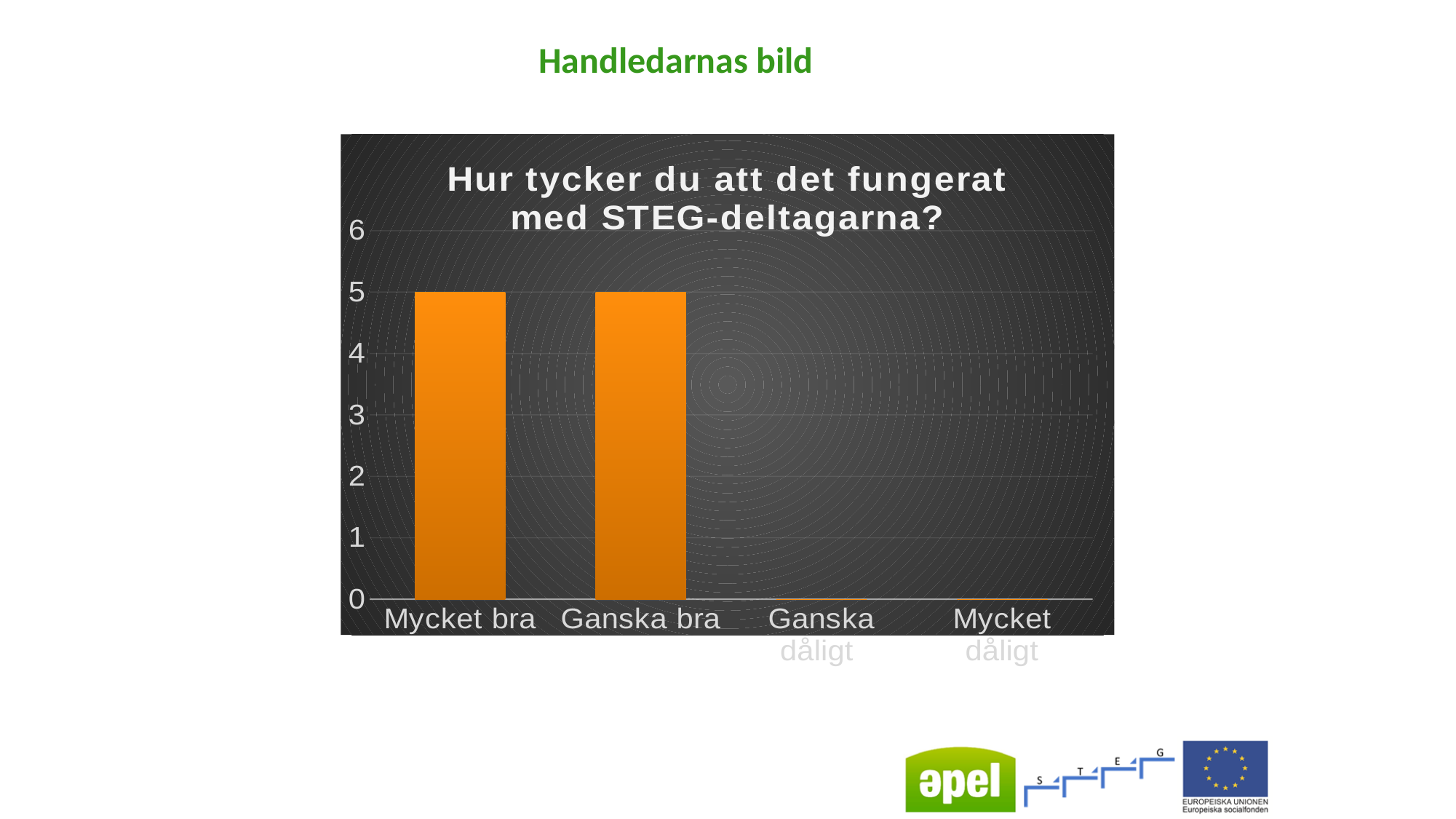
What is the value for Mycket dåligt? 0 What colour are the bars in the chart? orange What is the value for Ganska dåligt? 0 What is the value for Mycket bra? 5 How many categories are shown on the x axis? 4 What is the title of the chart? Hur tycker du att det fungerat med STEG-deltagarna? Is the value for Ganska bra greater or less than 6? less What is the difference between the value for Ganska bra and the value for Mycket dåligt? 5 What is the value for Ganska bra? 5 Is the value for Mycket bra greater or less than 4? greater Which is larger, the value for Mycket bra or the value for Ganska dåligt? Mycket bra What kind of chart is shown on the slide? bar chart